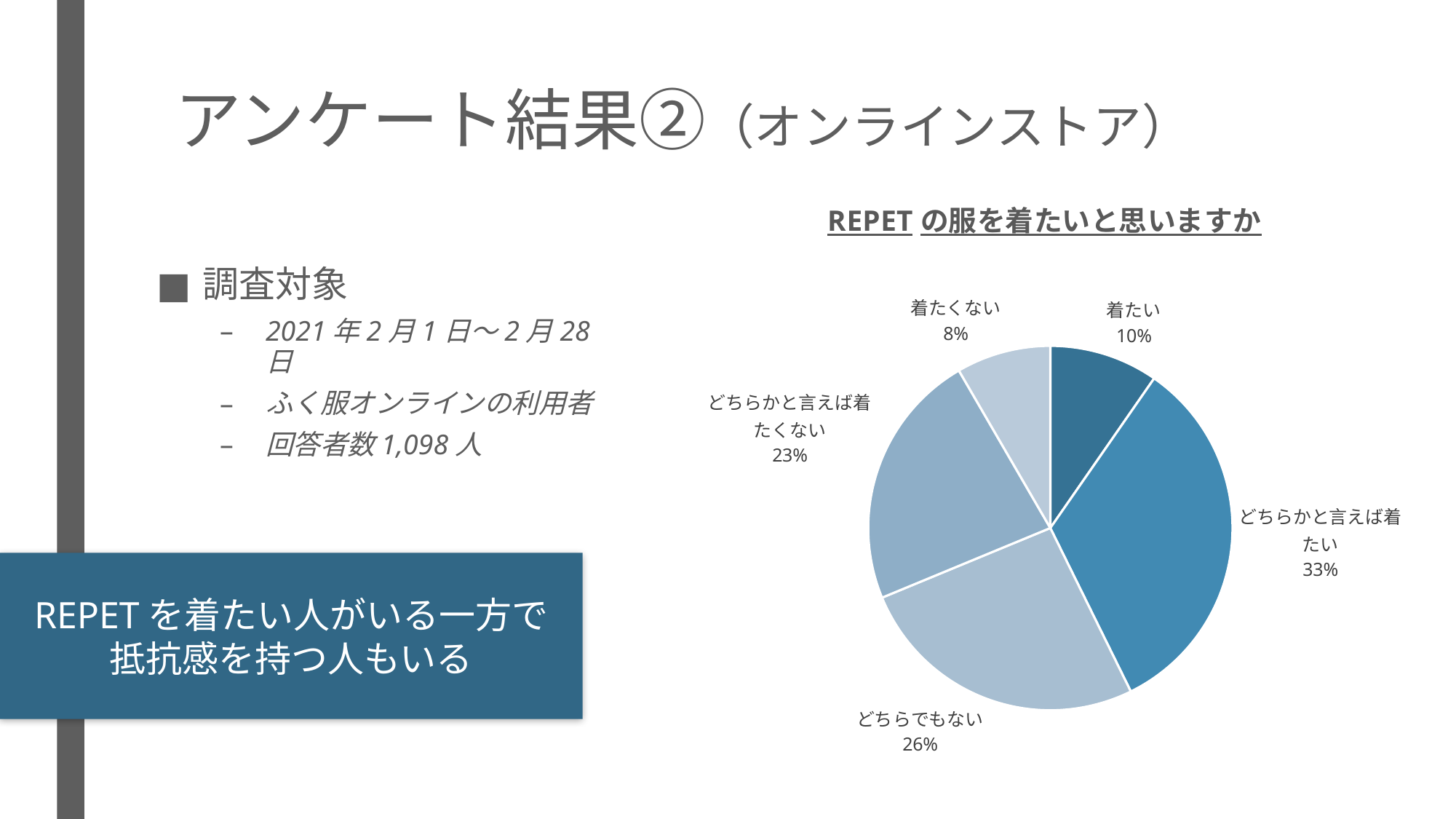
How many slices does the pie chart have? 5 What share of respondents answered 着たい? 10% What share of respondents answered どちらかと言えば着たい? 33% What share of respondents answered 着たくない? 8% What kind of chart is shown on the slide? pie chart Which is larger, the share for どちらでもない or the share for どちらかと言えば着たくない? どちらでもない What share of respondents answered どちらかと言えば着たくない? 23% Which response has the largest share of the pie? どちらかと言えば着たい Which response has the smallest share of the pie? 着たくない What share of respondents answered どちらでもない? 26% What is the title of the pie chart? REPET の服を着たいと思いますか What is the difference in percentage points between どちらかと言えば着たい and 着たい? 23